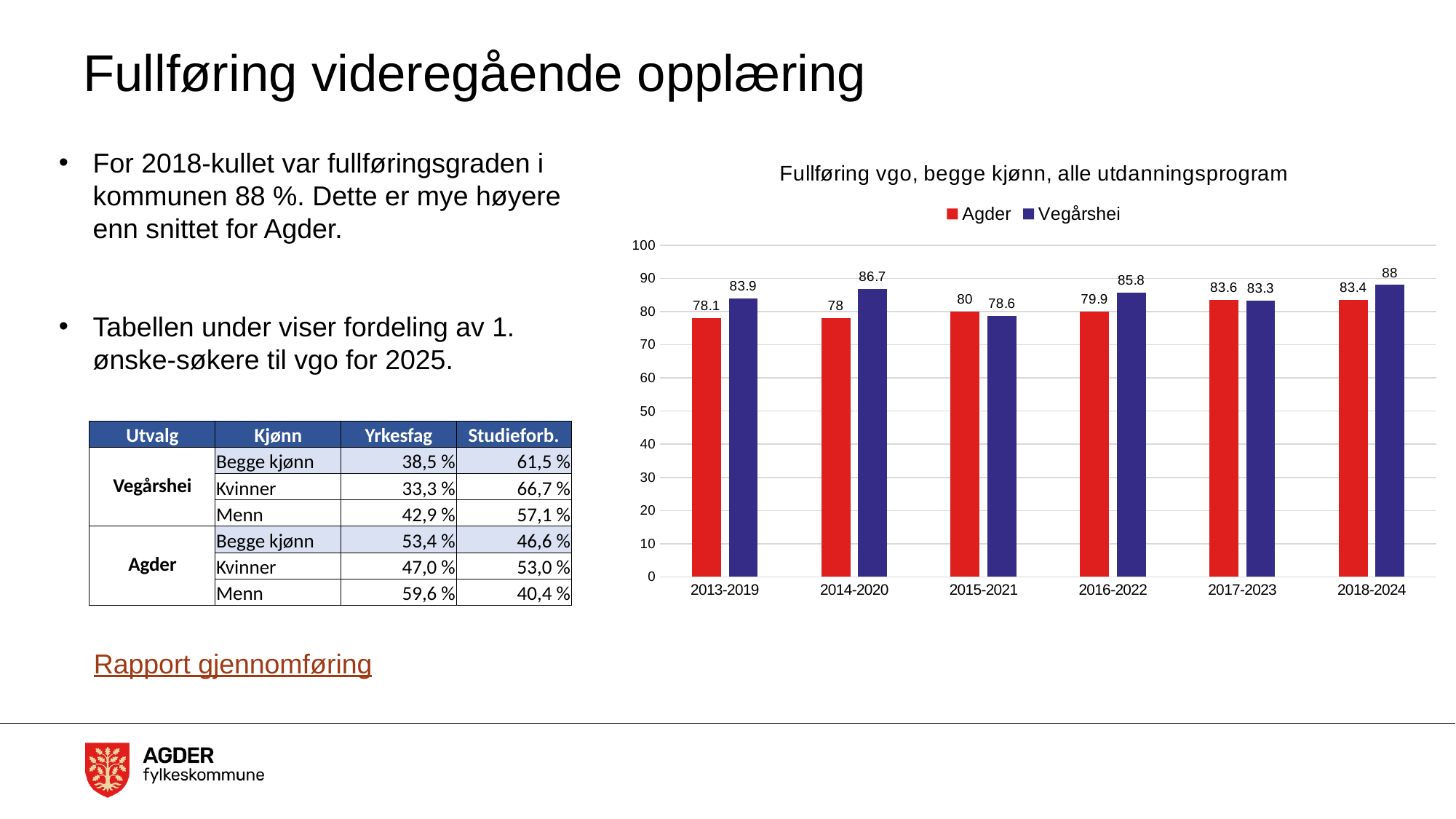
Which period has the lowest value for Agder? 2014-2020 What is the title of the chart? Fullføring vgo, begge kjønn, alle utdanningsprogram What kind of chart is shown? bar chart What is the value for Vegårshei in 2014-2020? 86.7 What is the value for Agder in 2013-2019? 78.1 How many periods are shown on the x axis? 6 Which is larger in 2015-2021, Agder or Vegårshei? Agder Is the value for Vegårshei in 2016-2022 greater or less than 80? greater What is the value for Vegårshei in 2018-2024? 88 What is the difference between Vegårshei and Agder in 2014-2020? 8.7 How many series does the legend list? 2 Which period has the highest value for Vegårshei? 2018-2024